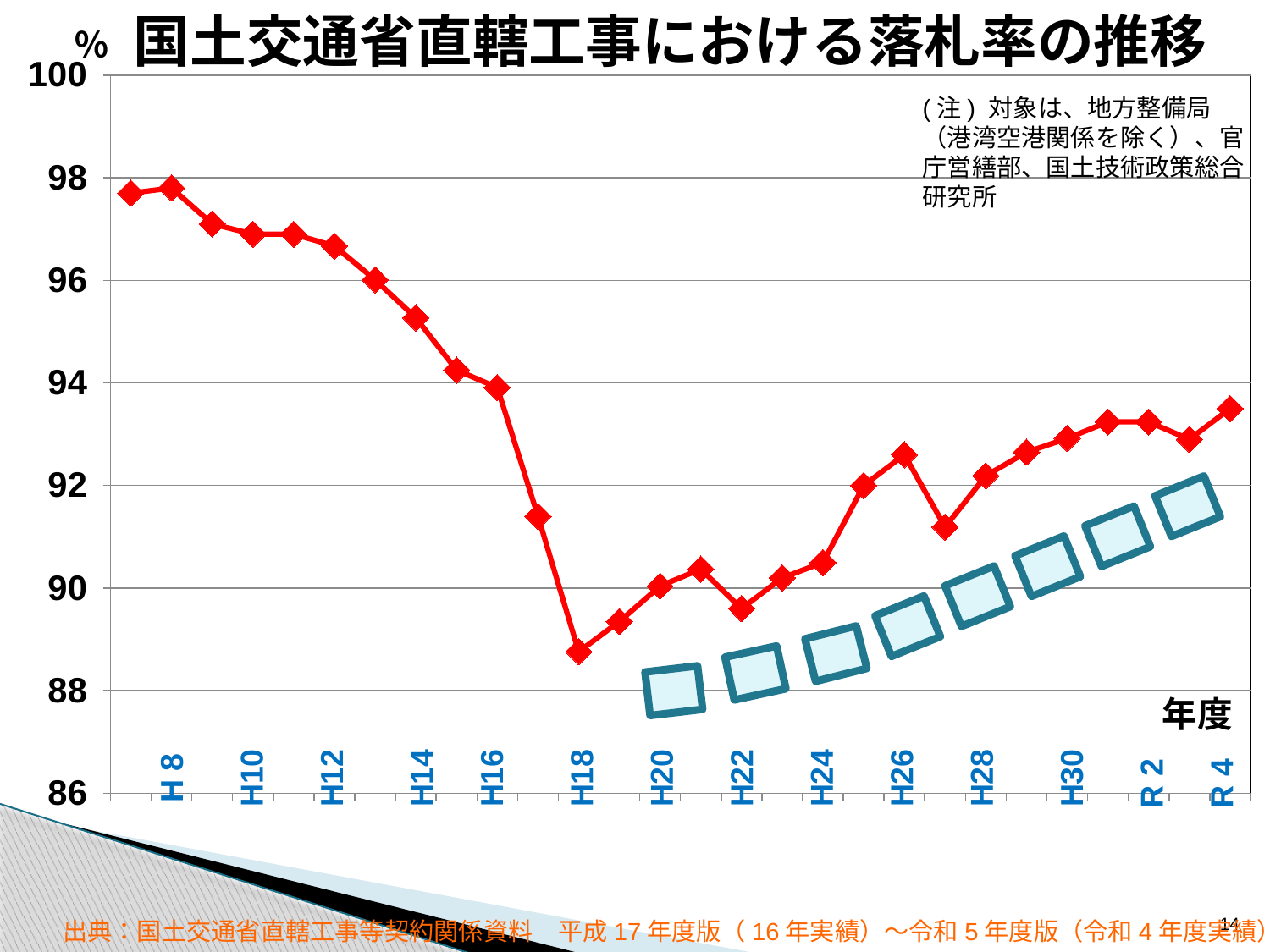
Do the values rise or fall from H8 to H18? fall What is the title of the chart? 国土交通省直轄工事における落札率の推移 Is the value for H16 greater or less than 96? less Which is larger, the value for H10 or the value for H30? H10 Is the value for H22 greater or less than 92? less Is the value for H8 greater or less than 96? greater Which labeled year has the lowest 落札率 in the chart? H18 What kind of chart is shown on the slide? line chart What unit is shown on the vertical axis of the chart? % How many year labels are shown along the x axis of the chart? 14